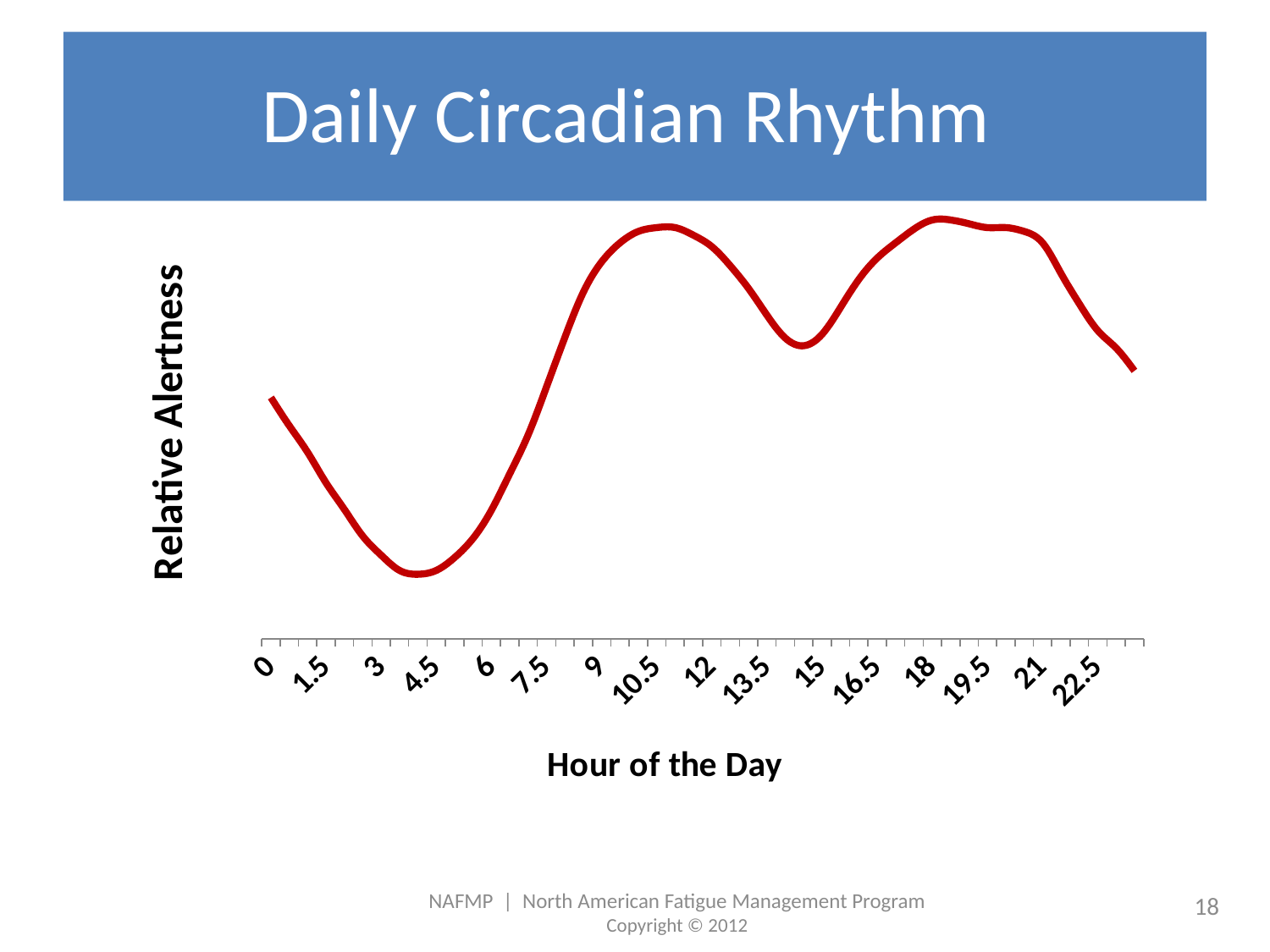
How many labelled tick values are shown on the x axis? 16 Does relative alertness rise or fall between hour 21 and the end of the day? Fall Is relative alertness higher at hour 0 or at hour 10.5? Hour 10.5 Does relative alertness rise or fall between hour 0 and hour 4.5? Fall What kind of chart is shown on the slide? Line chart What is the title of the chart? Daily Circadian Rhythm Does relative alertness rise or fall between hour 4.5 and hour 10.5? Rise Is relative alertness higher at hour 9 or at hour 3? Hour 9 What is the label of the x axis? Hour of the Day Is relative alertness higher at hour 15 or at hour 4.5? Hour 15